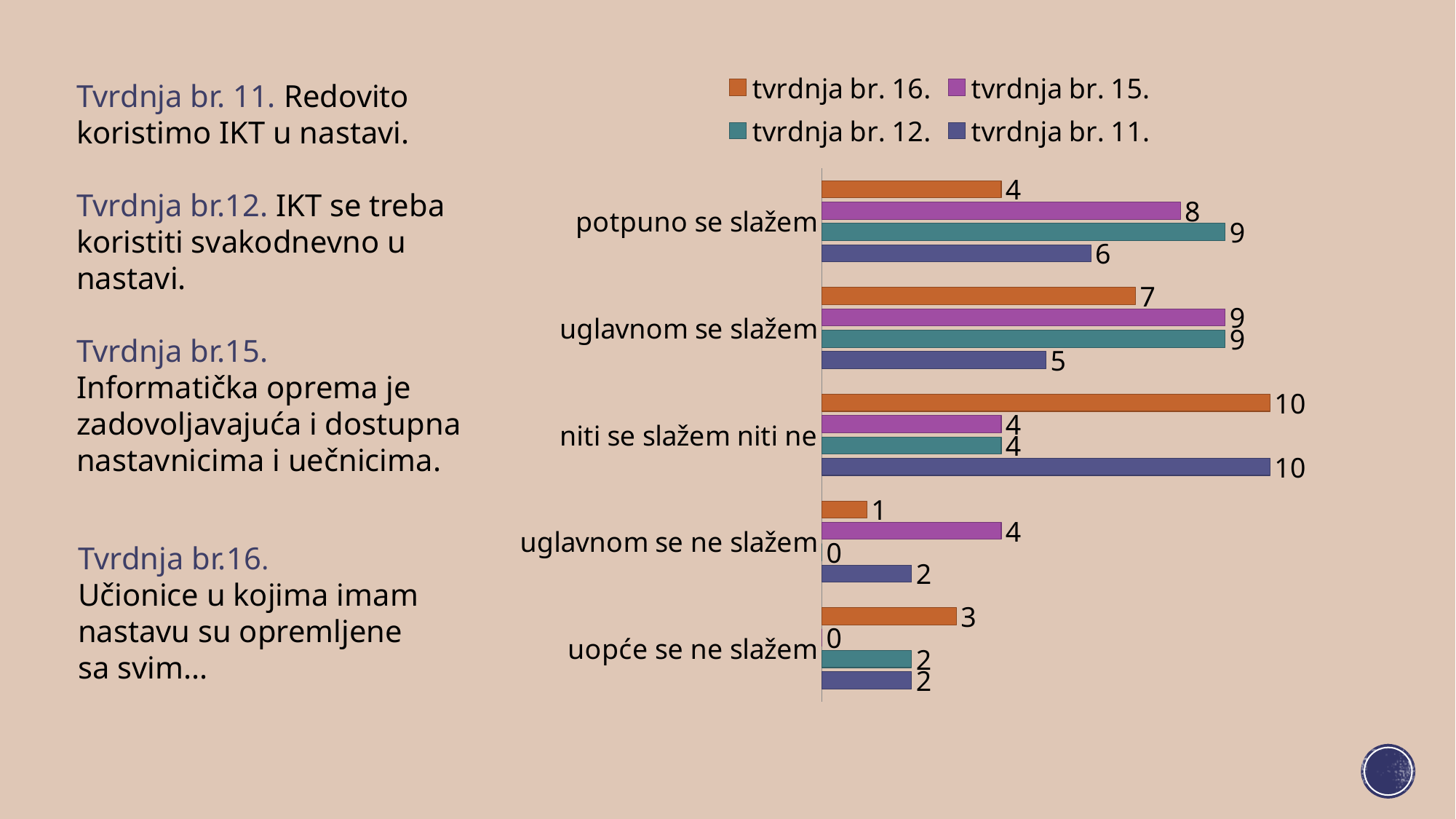
In the category "potpuno se slažem", which is larger: tvrdnja br. 15. or tvrdnja br. 11.? tvrdnja br. 15. What is the value for tvrdnja br. 15. in the category "uglavnom se ne slažem"? 4 What type of chart is shown on the slide? bar chart What is the value for tvrdnja br. 12. in the category "potpuno se slažem"? 9 What is the difference between tvrdnja br. 16. and tvrdnja br. 11. in the category "uglavnom se slažem"? 2 In which category does tvrdnja br. 15. have its lowest value? uopće se ne slažem Which series is shown in orange in the legend? tvrdnja br. 16. In which category does tvrdnja br. 16. have its highest value? niti se slažem niti ne How many response categories are shown on the chart? 5 How many series does the legend list? 4 What is the value for tvrdnja br. 11. in the category "niti se slažem niti ne"? 10 What is the value for tvrdnja br. 16. in the category "uopće se ne slažem"? 3